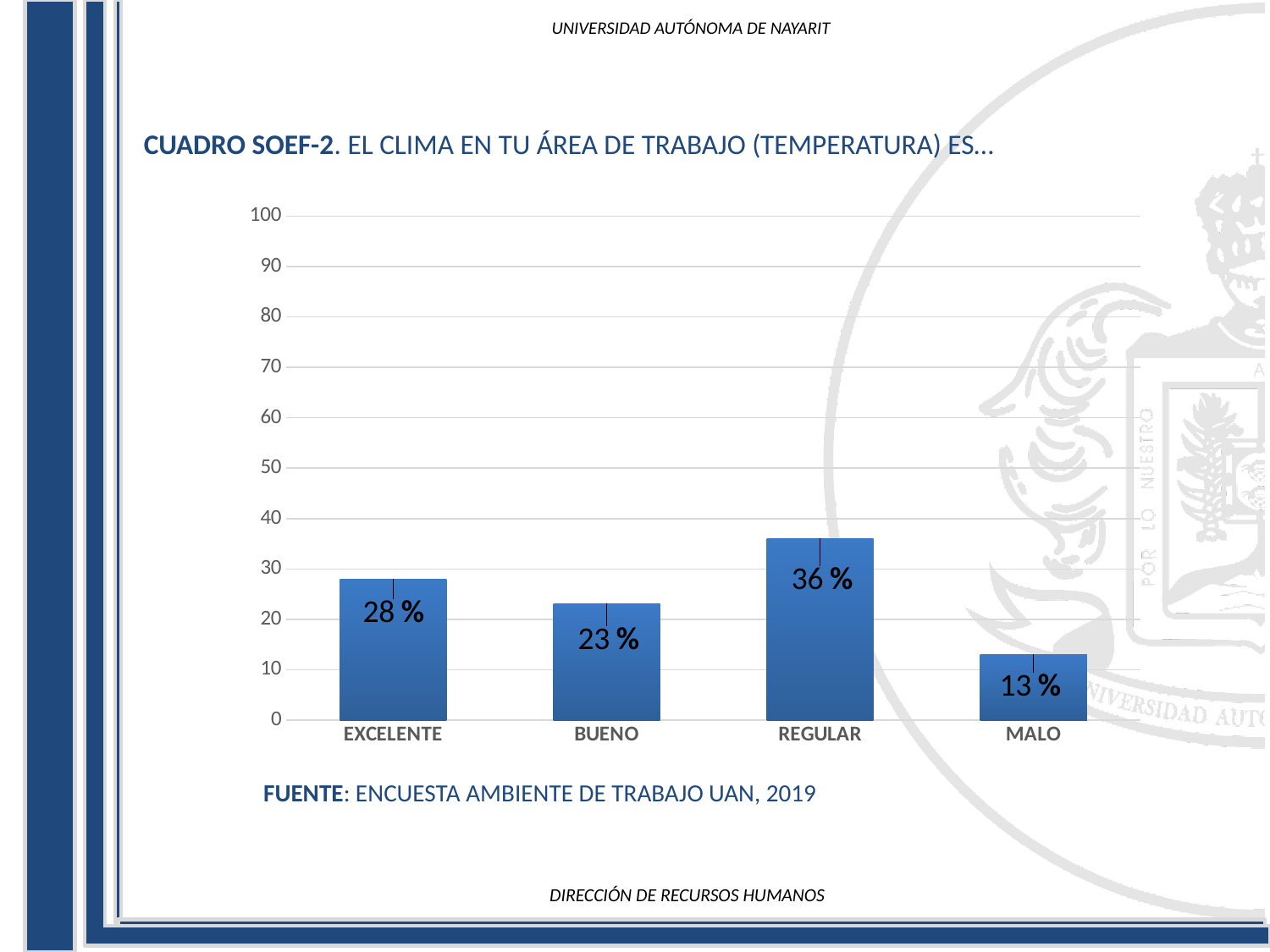
What kind of chart is shown on the slide? bar chart What is the value for MALO? 13 % What is the difference between the values for EXCELENTE and BUENO? 5 % Which category has the lowest value? MALO What is the value for BUENO? 23 % What is the value for REGULAR? 36 % Which is larger, the value for EXCELENTE or the value for BUENO? EXCELENTE What is the difference between the values for REGULAR and MALO? 23 % What is the value for EXCELENTE? 28 % How many categories are shown on the x axis? 4 Which category has the highest value? REGULAR Is the value for REGULAR greater or less than 30? greater